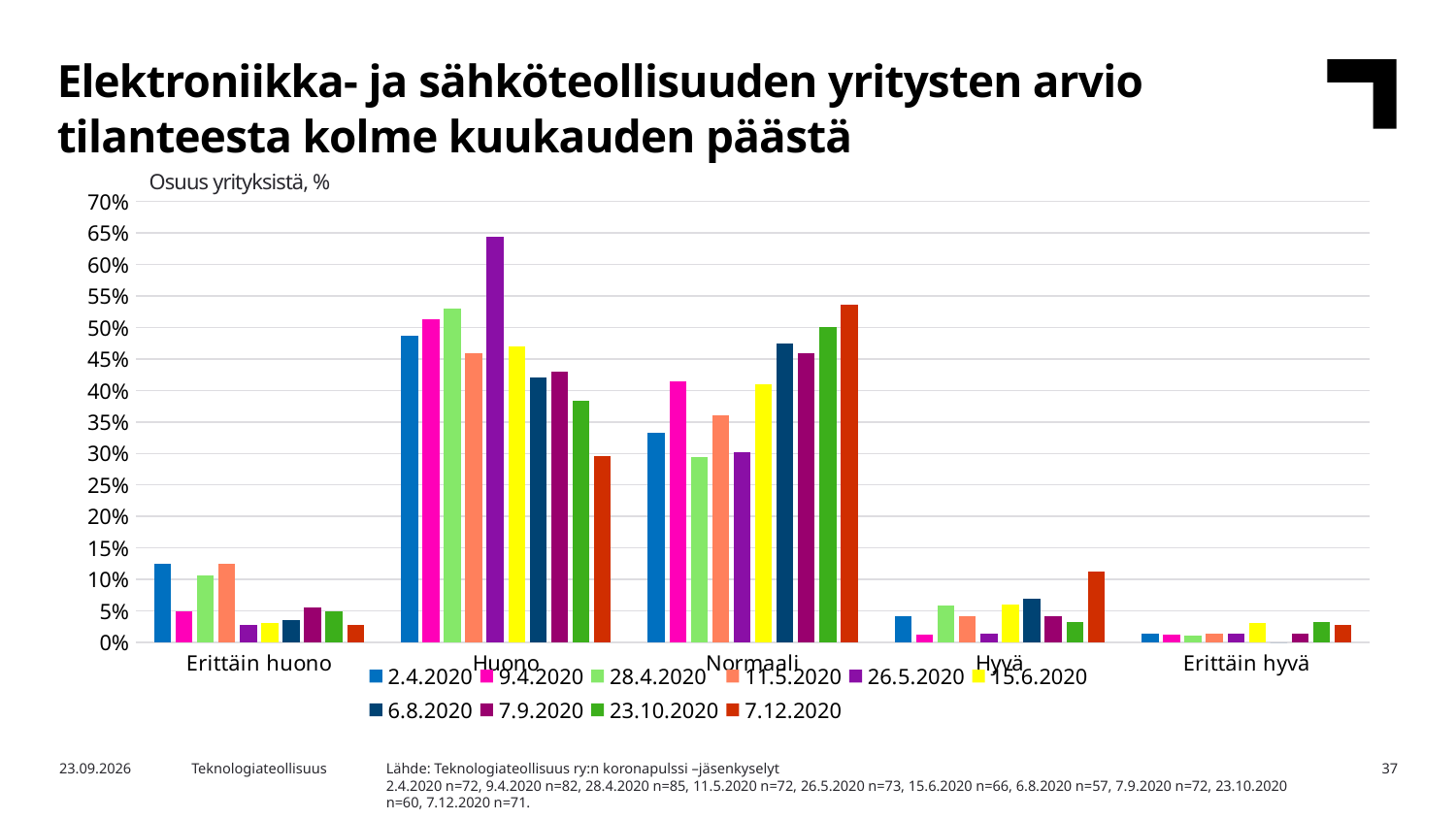
Is the value for 7.12.2020 in the Normaali category greater or less than 50%? greater Which series has the highest value in the Huono category? 26.5.2020 Is the value for 2.4.2020 in the Erittäin huono category greater or less than 10%? greater What kind of chart is shown on the slide? bar chart Which is larger for the 26.5.2020 series: the value for Huono or the value for Normaali? Huono How many categories are shown on the x axis? 5 How many series does the legend list? 10 Which series has the highest value in the Hyvä category? 7.12.2020 Which series has the lowest value in the Huono category? 7.12.2020 Is the value for 26.5.2020 in the Huono category greater or less than 60%? greater What is the label on the vertical axis of the chart? Osuus yrityksistä, % Which series has the highest value in the Normaali category? 7.12.2020